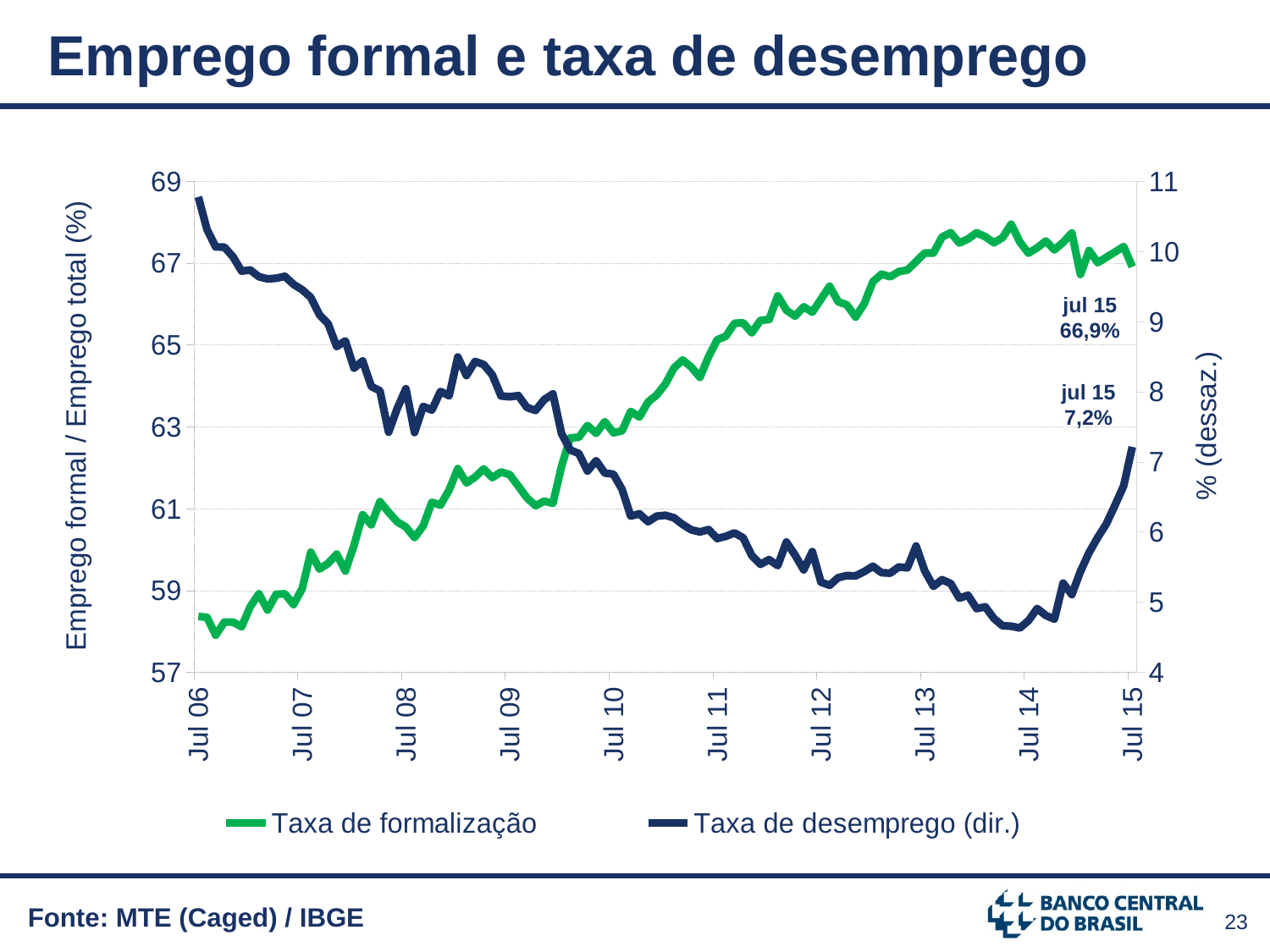
How many year labels are shown on the x axis? 10 Which series is plotted on the right-hand axis? Taxa de desemprego (dir.) Is the value of Taxa de desemprego at Jul 12 greater or less than 6? less What kind of chart is shown on the slide? Line chart Does the Taxa de formalização line rise or fall overall from Jul 06 to Jul 15? Rise What is the value of Taxa de formalização labelled for jul 15? 66,9% Does the Taxa de desemprego line rise or fall overall from Jul 06 to Jul 14? Fall How many series does the legend list? 2 What is the value of Taxa de desemprego labelled for jul 15? 7,2% Is the value of Taxa de formalização at Jul 06 greater or less than 59? less Is the value of Taxa de formalização at Jul 13 greater or less than 67? greater